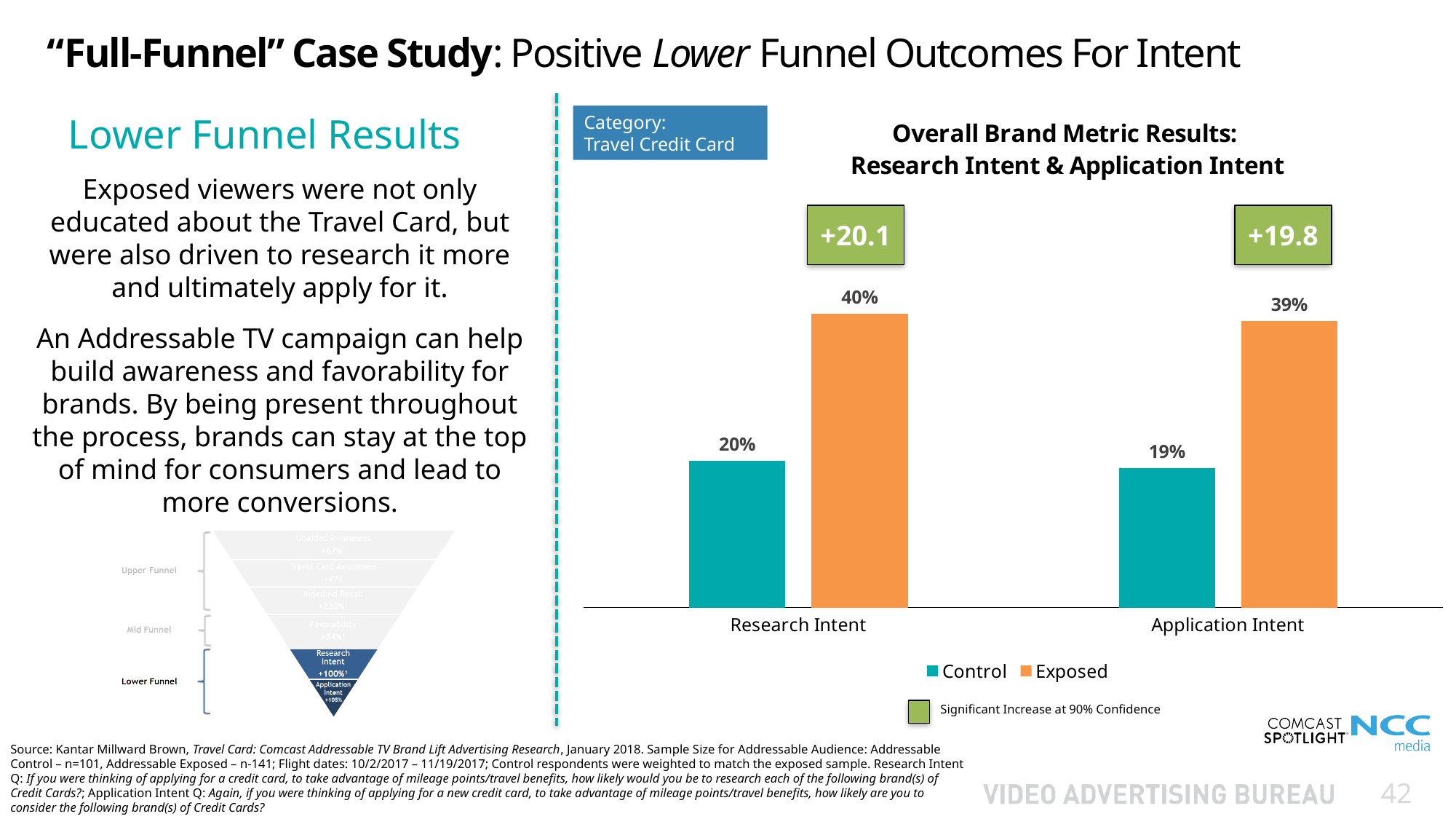
What is the Exposed value for Application Intent? 39% Which category has the lowest Control value? Application Intent Which category has the highest Exposed value? Research Intent How many categories are shown on the x axis of the chart? 2 What is the Control value for Research Intent? 20% What is the Exposed value for Research Intent? 40% What is the difference between the Exposed and Control values for Research Intent? 20% What kind of chart is shown on the slide? Bar chart What is the Control value for Application Intent? 19% What lift value is shown in the green box above the Application Intent bars? +19.8 How many series does the chart legend list? 2 For Application Intent, which is larger: the Control value or the Exposed value? Exposed